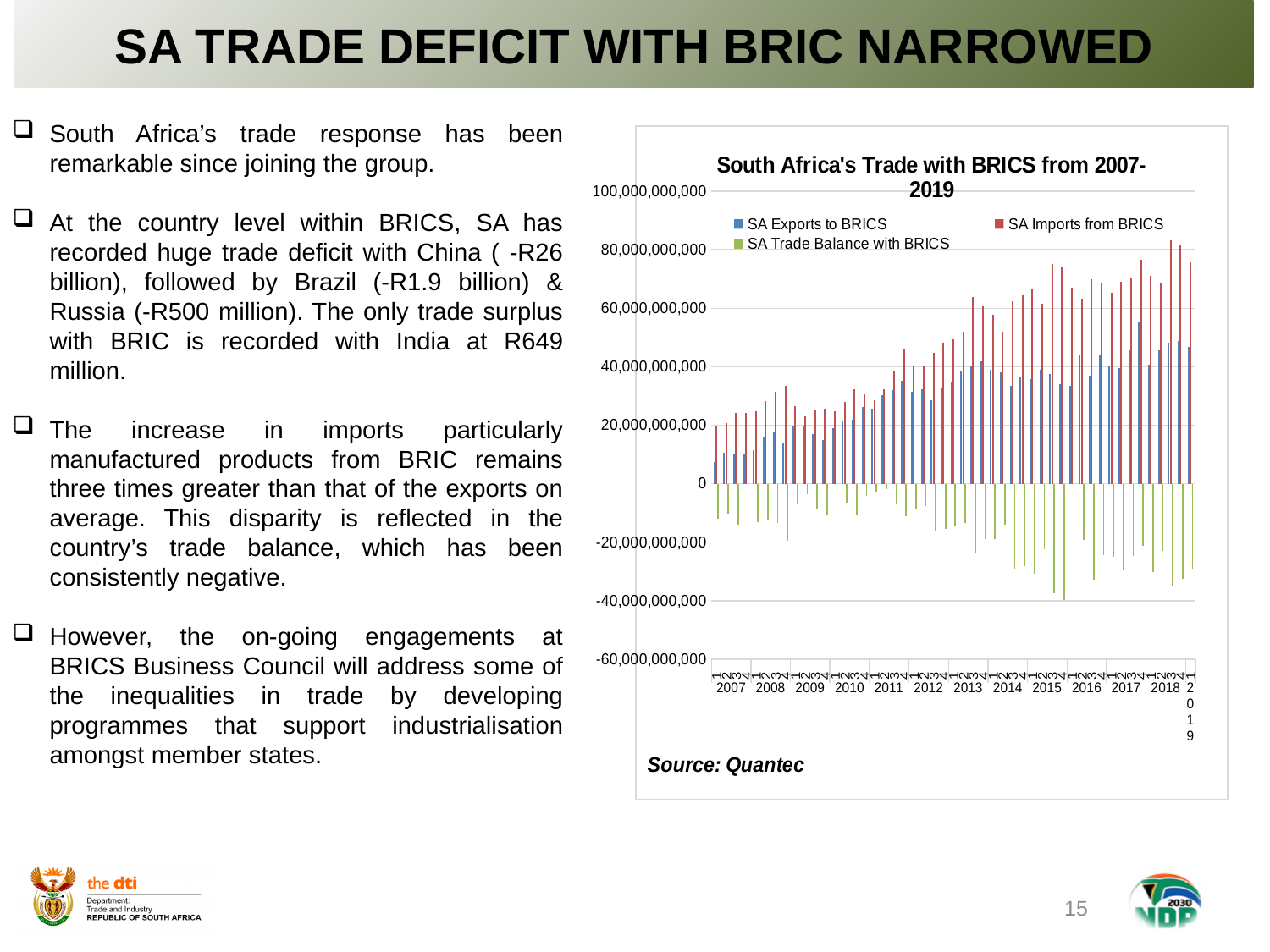
What kind of chart is shown on the slide? Bar chart How many series does the chart's legend list? 3 Is the value for SA Imports from BRICS in the third quarter of 2015 greater or less than 60,000,000,000? greater Is the value for SA Trade Balance with BRICS in the third quarter of 2015 greater or less than -20,000,000,000? less What is the title of the chart? South Africa's Trade with BRICS from 2007-2019 What source is cited for the chart? Quantec Is the value for SA Exports to BRICS in the first quarter of 2007 greater or less than 20,000,000,000? less In the third quarter of 2018, which is larger: SA Exports to BRICS or SA Imports from BRICS? SA Imports from BRICS What is the highest value labelled on the chart's vertical axis? 100,000,000,000 How many years are labelled along the x axis of the chart? 13 Which series in the chart is plotted with negative values throughout the period? SA Trade Balance with BRICS Do SA Exports to BRICS generally rise or fall from 2007 to 2018? Rise